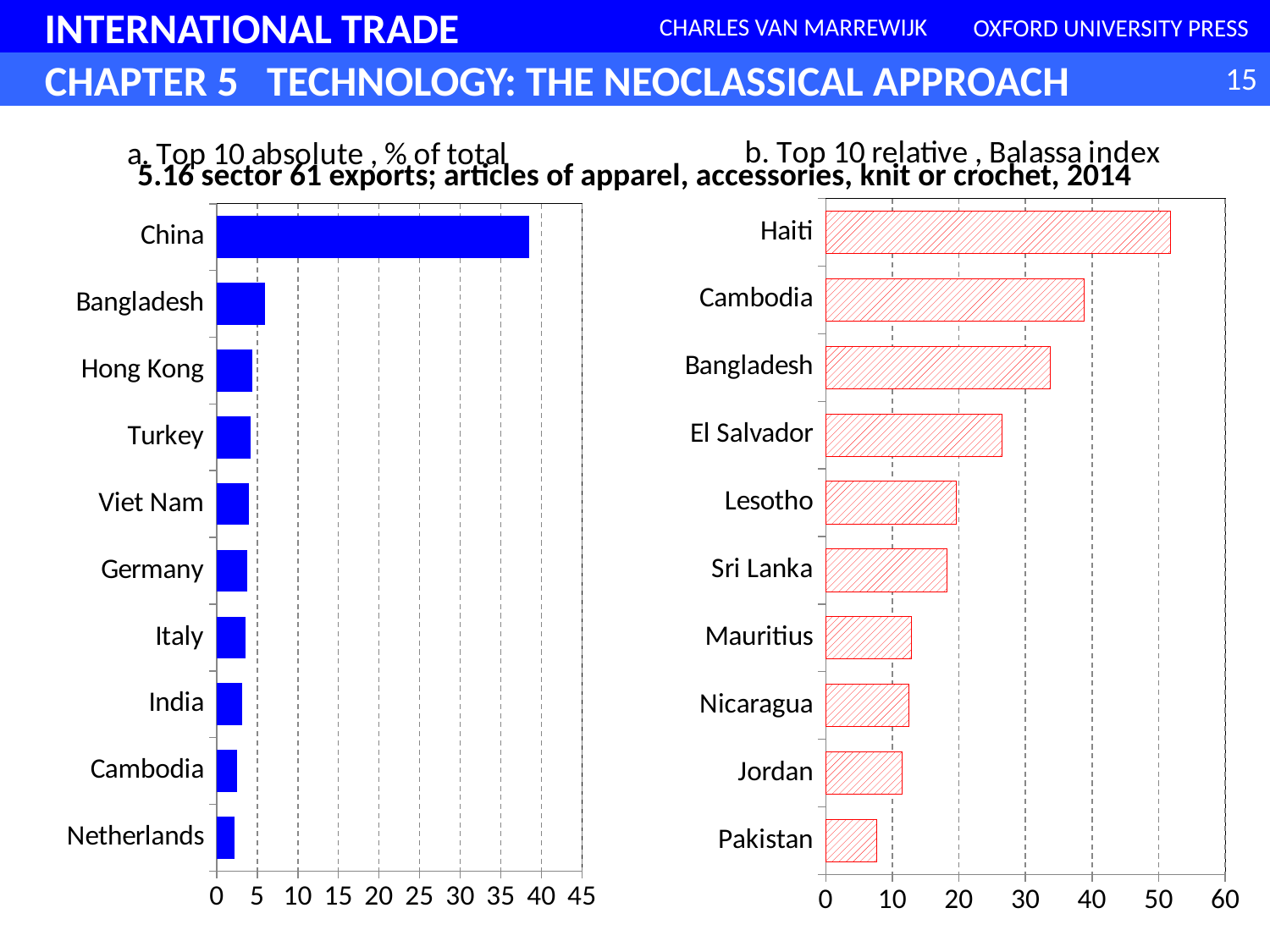
In chart b, 'Top 10 relative, Balassa index', is the value for Haiti greater or less than 50? greater In chart a, 'Top 10 absolute, % of total', is the value for China greater or less than 35? greater What kind of chart is chart a, 'Top 10 absolute, % of total'? bar chart In chart b, 'Top 10 relative, Balassa index', which country has the highest value? Haiti In chart a, 'Top 10 absolute, % of total', which country has the highest value? China In chart b, 'Top 10 relative, Balassa index', which is larger, the value for Cambodia or the value for El Salvador? Cambodia In chart a, 'Top 10 absolute, % of total', which country has the lowest value? Netherlands How many countries are shown in chart a, 'Top 10 absolute, % of total'? 10 What is the overall title shown above the two charts? 5.16 sector 61 exports; articles of apparel, accessories, knit or crochet, 2014 In chart b, 'Top 10 relative, Balassa index', is the value for Pakistan greater or less than 10? less In chart b, 'Top 10 relative, Balassa index', which country has the lowest value? Pakistan